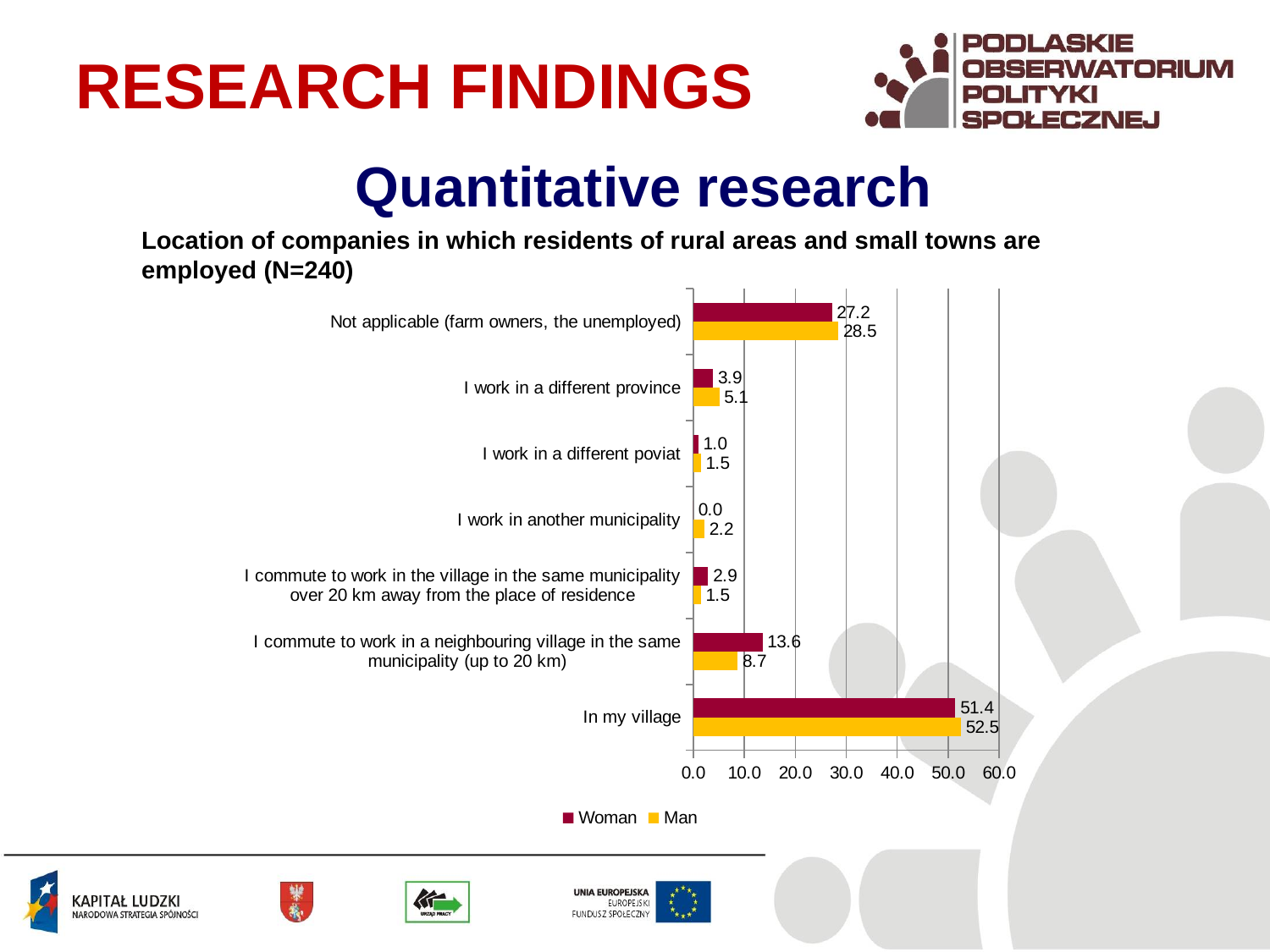
Which is larger for 'I work in a different province', the Woman value or the Man value? Man How many series does the legend list? 2 What is the value for Man in the 'Not applicable (farm owners, the unemployed)' category? 28.5 What is the value for Woman in the 'In my village' category? 51.4 Which category has the lowest value for Woman? I work in another municipality Which series is shown in yellow in the legend? Man What is the difference between the Man and Woman values for 'I commute to work in a neighbouring village in the same municipality (up to 20 km)'? 4.9 What kind of chart is shown on the slide? Bar chart Is the Man value for 'In my village' greater or less than 50.0? greater Which category has the highest value for Woman? In my village What is the value for Man in the 'I work in another municipality' category? 2.2 How many categories are shown on the chart? 7